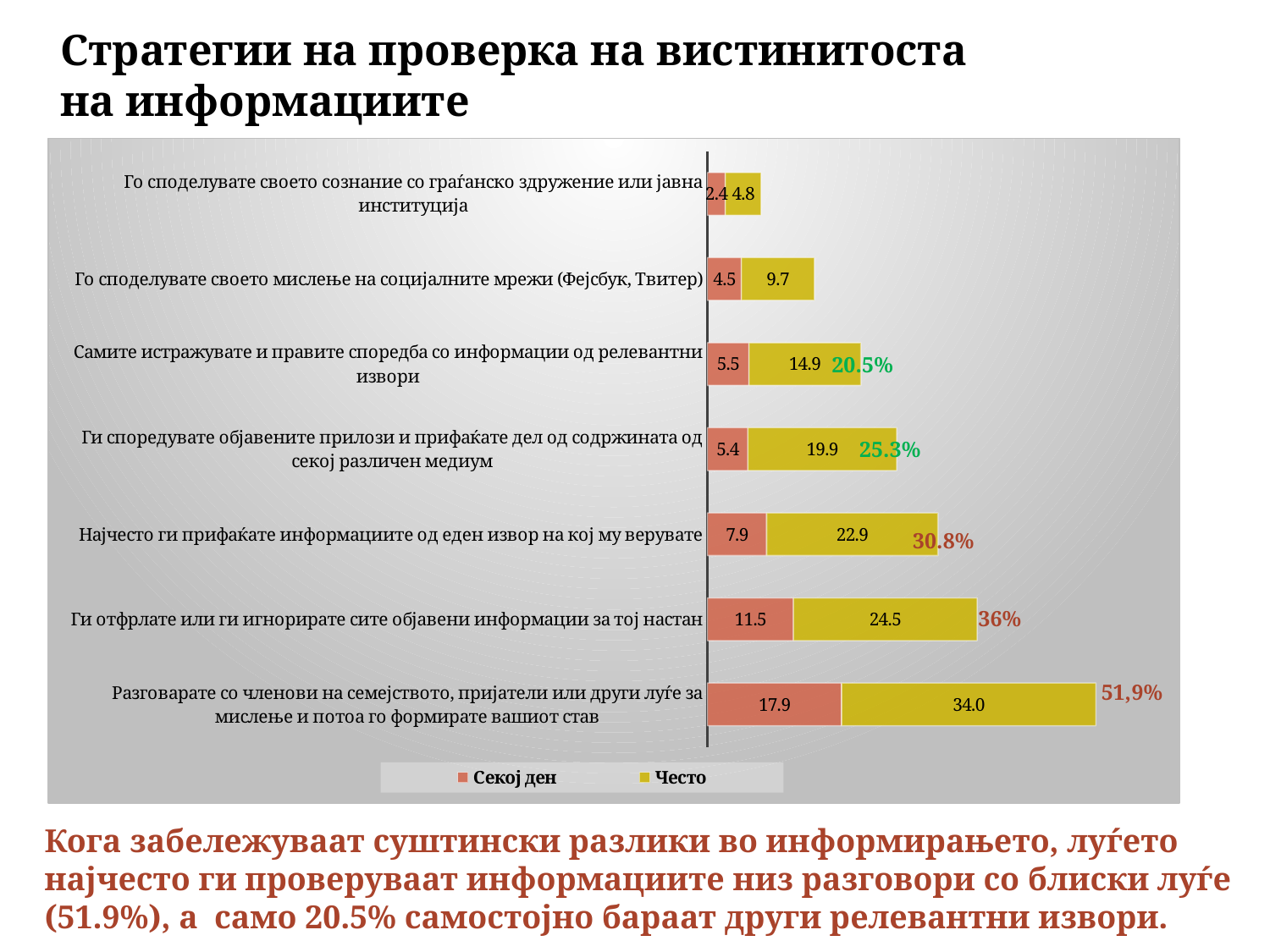
How many series does the legend list? 2 Which is larger: the "Секој ден" value for "Ги отфрлате или ги игнорирате сите објавени информации за тој настан" or for "Најчесто ги прифаќате информациите од еден извор на кој му верувате"? Ги отфрлате или ги игнорирате сите објавени информации за тој настан What colour represents the "Често" series in the chart? Yellow Which category has the lowest "Секој ден" value? Го споделувате своето сознание со граѓанско здружение или јавна институција What type of chart is shown on the slide? Stacked bar chart What is the difference between the "Често" values for "Ги споредувате објавените прилози и прифаќате дел од содржината од секој различен медиум" and "Самите истражувате и правите споредба со информации од релевантни извори"? 5.0 What is the value of the "Често" series for "Го споделувате своето мислење на социјалните мрежи (Фејсбук, Твитер)"? 9.7 Which category has the highest "Често" value? Разговарате со членови на семејството, пријатели или други луѓе за мислење и потоа го формирате вашиот став What is the value of the "Често" series for "Ги отфрлате или ги игнорирате сите објавени информации за тој настан"? 24.5 How many categories are plotted in the chart? 7 What is the value of the "Секој ден" series for "Разговарате со членови на семејството, пријатели или други луѓе за мислење и потоа го формирате вашиот став"? 17.9 What is the total printed for the stacked bar "Најчесто ги прифаќате информациите од еден извор на кој му верувате"? 30.8%